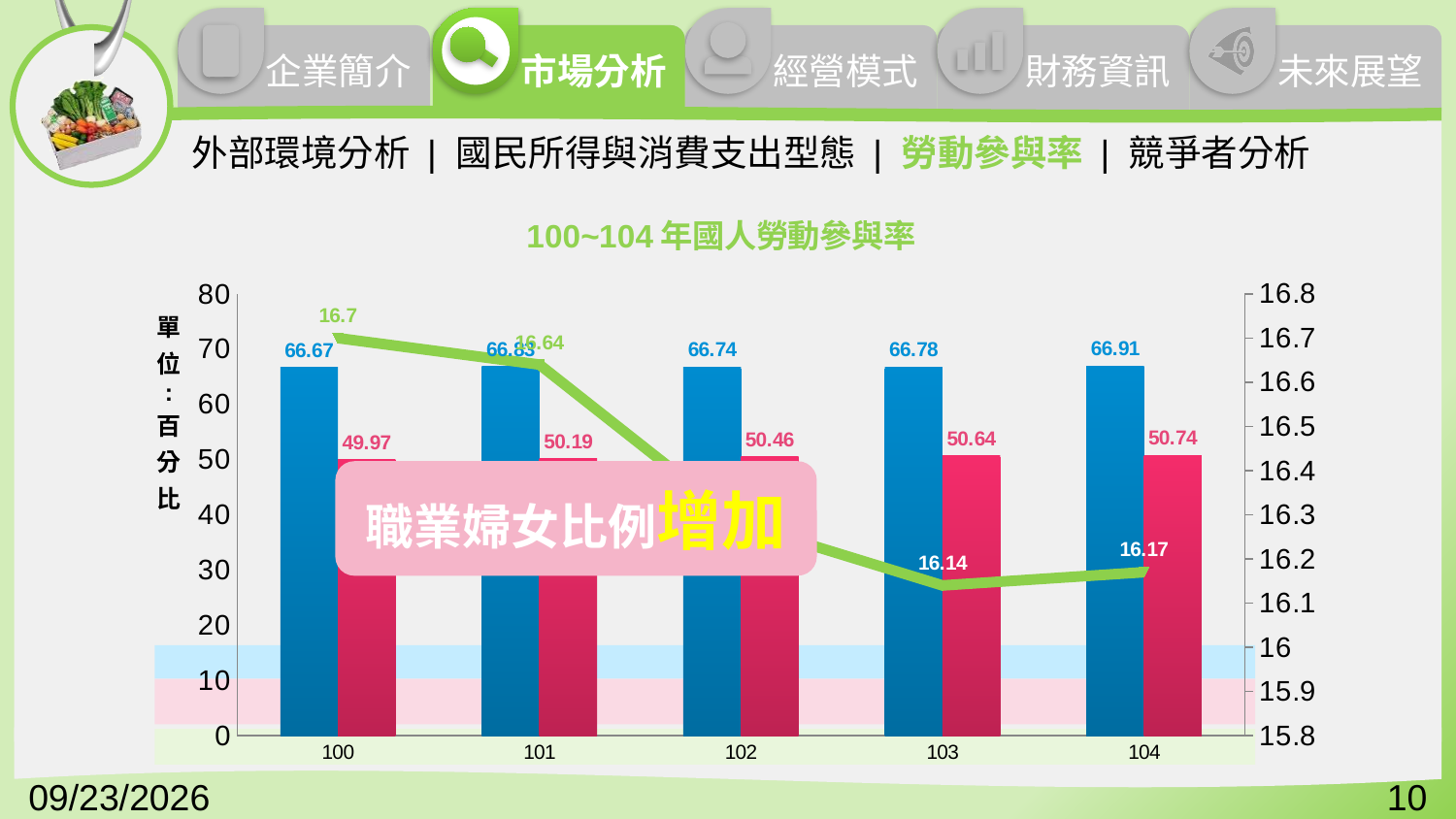
How many years (categories) are shown on the x axis of the chart? 5 What is the value of the blue bar for year 104? 66.91 What is the value of the green line at year 100? 16.7 Which year has the lowest blue bar? 100 Is the value of the blue bar for year 102 greater or less than 60? greater Which is larger, the pink bar for year 103 or the pink bar for year 102? 103 What is the value of the green line at year 103? 16.14 What is the value of the pink bar for year 100? 49.97 Which year has the highest pink bar? 104 What is the difference between the blue bar values for year 104 and year 100? 0.24 Do the pink bar values rise or fall from year 100 to year 104? rise What is the title of the chart? 100~104 年國人勞動參與率